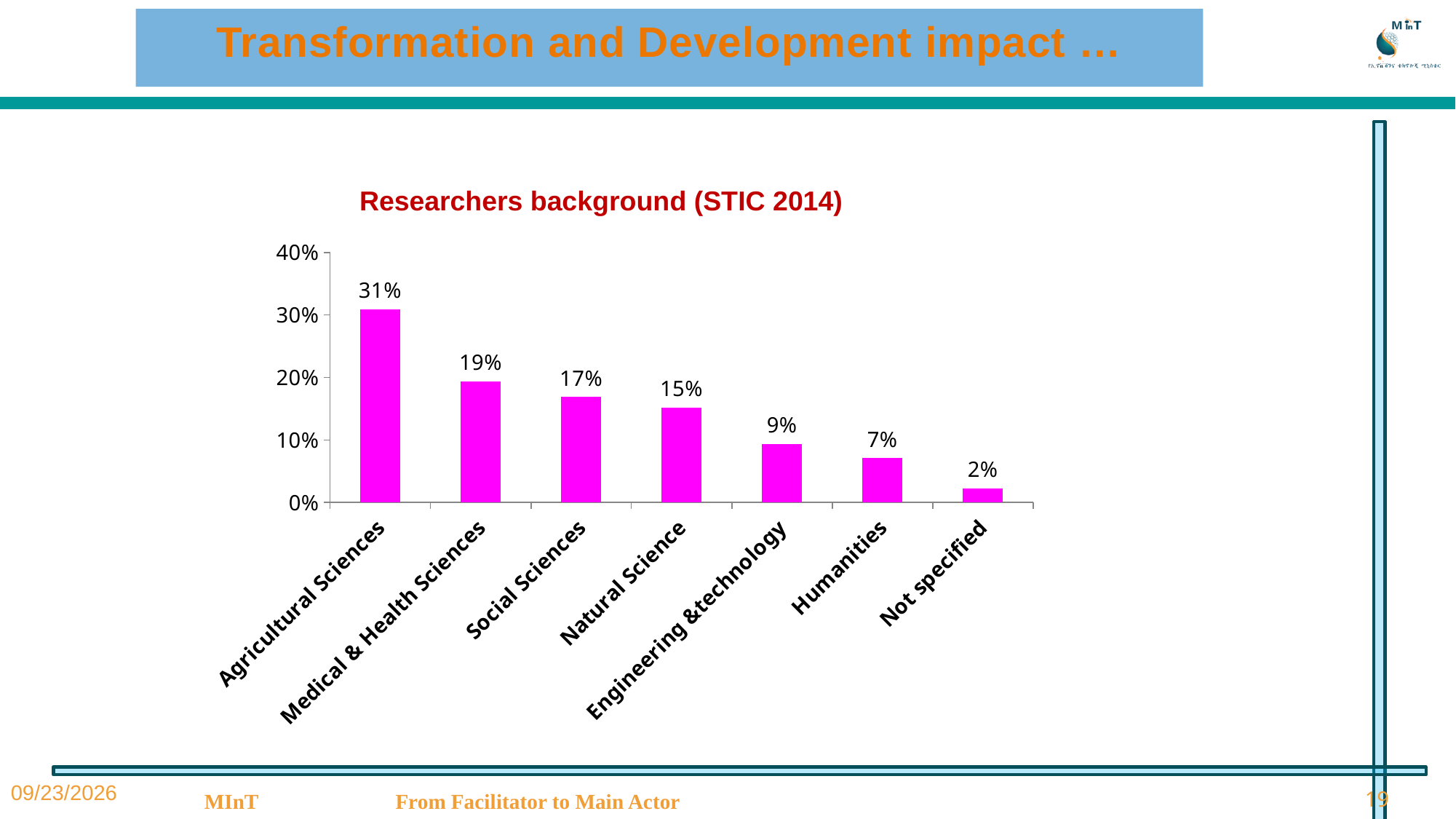
What is the value for Agricultural Sciences? 31% What is the difference between Agricultural Sciences and Medical & Health Sciences? 12% What is the value for Engineering &technology? 9% What is the difference between Natural Science and Humanities? 8% What kind of chart is shown on the slide? Bar chart What is the value for Not specified? 2% What is the title of the chart? Researchers background (STIC 2014) Which is larger, Social Sciences or Natural Science? Social Sciences Is the value for Medical & Health Sciences greater or less than 10%? greater How many categories are shown in the chart? 7 Which category has the highest value? Agricultural Sciences Which category has the lowest value? Not specified